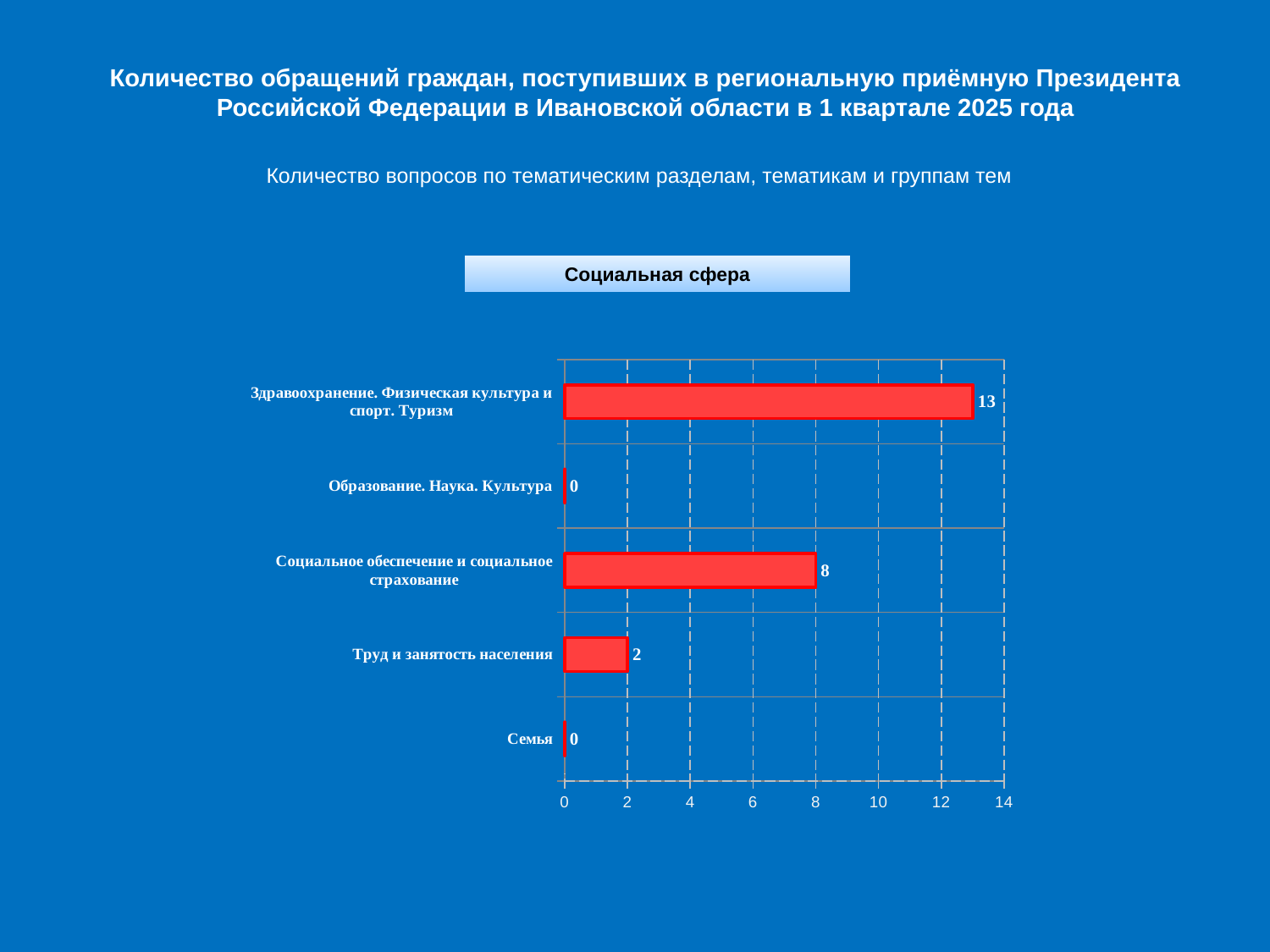
What kind of chart is shown on the slide? bar chart Which category has the highest value? Здравоохранение. Физическая культура и спорт. Туризм What is the heading shown above the chart? Социальная сфера How many categories are shown in the chart? 5 What is the value for «Семья»? 0 Is the value for «Здравоохранение. Физическая культура и спорт. Туризм» greater or less than 10? greater How many categories have a value of 0? 2 What is the value for «Здравоохранение. Физическая культура и спорт. Туризм»? 13 What is the difference between the values for «Здравоохранение. Физическая культура и спорт. Туризм» and «Социальное обеспечение и социальное страхование»? 5 What is the value for «Социальное обеспечение и социальное страхование»? 8 What is the value for «Труд и занятость населения»? 2 Which is larger: the value for «Социальное обеспечение и социальное страхование» or the value for «Труд и занятость населения»? Социальное обеспечение и социальное страхование